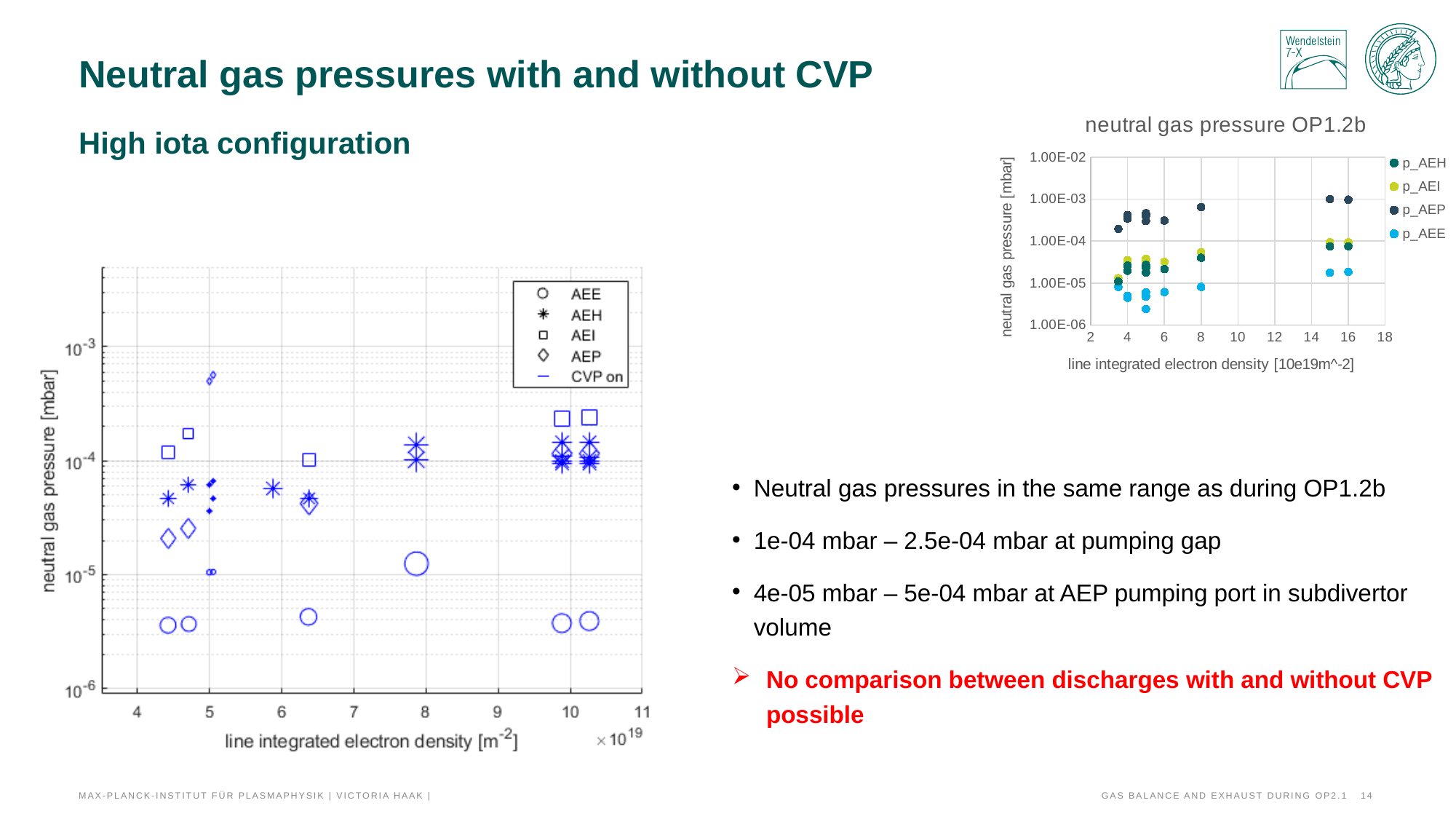
In the right chart 'neutral gas pressure OP1.2b', which series has the highest pressure values overall? p_AEP In the right chart 'neutral gas pressure OP1.2b', is the p_AEE value at a line integrated electron density of 5 greater or less than 1.00E-05? less What kind of chart is the right chart titled 'neutral gas pressure OP1.2b'? Scatter plot In the left chart, which marker symbol does the legend use for AEE? Circle In the right chart 'neutral gas pressure OP1.2b', which series has the lowest pressure values overall? p_AEE In the right chart 'neutral gas pressure OP1.2b', is the p_AEP value at a line integrated electron density of 4 greater or less than 1.00E-04? greater How many series does the legend of the right chart 'neutral gas pressure OP1.2b' list? 4 In the left chart, are the AEE values near a line integrated electron density of 4.4×10^19 greater or less than 10^-5 mbar? less What kind of chart is the left chart on the slide? Scatter plot What is the title of the chart on the right side of the slide? neutral gas pressure OP1.2b In the left chart, at a line integrated electron density of about 4.4×10^19, which is larger: the AEI value or the AEE value? AEI